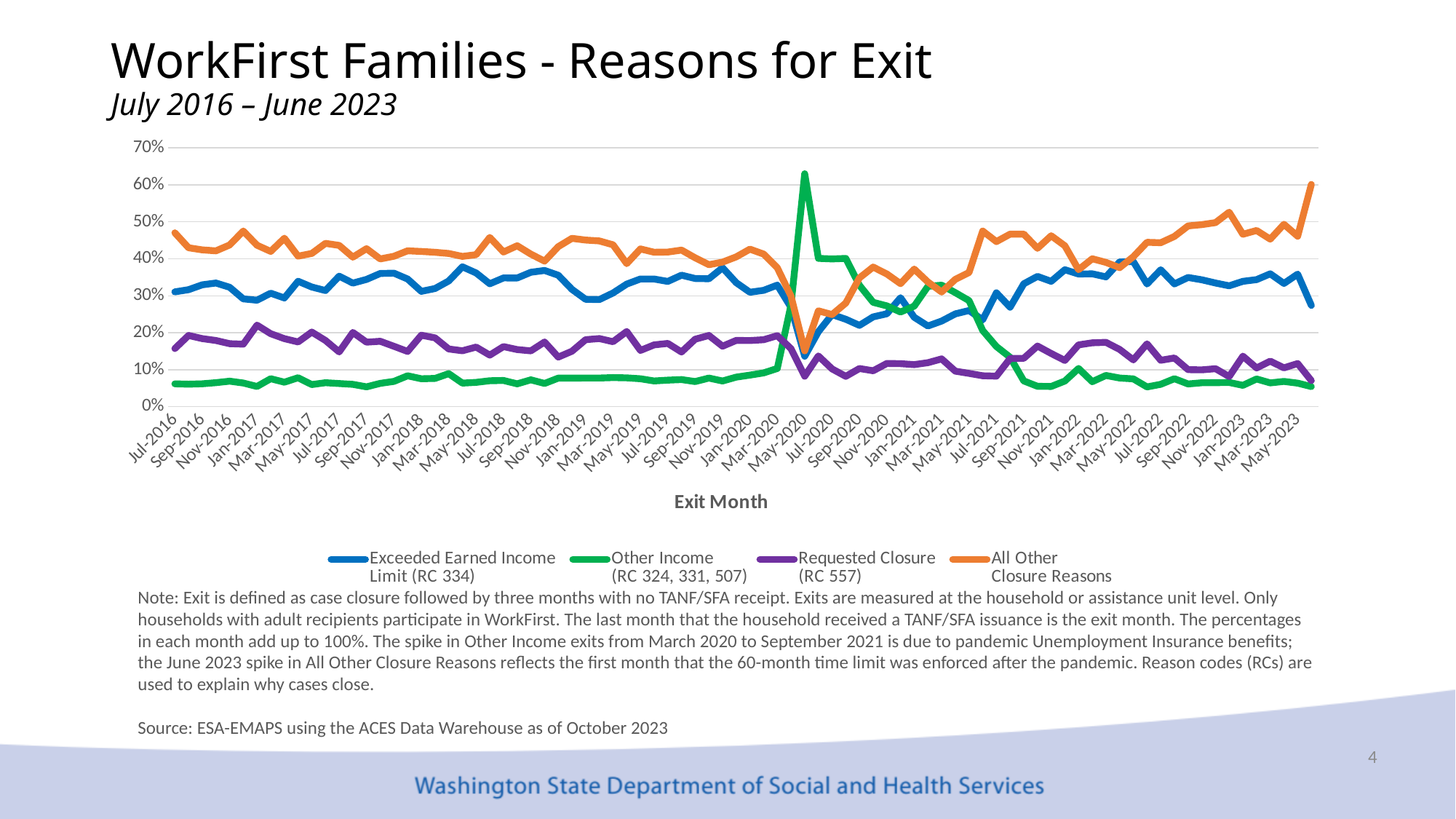
Does the Requested Closure series rise or fall overall from Jul-2016 to the end of the chart? fall What is the title of the x axis? Exit Month What are the four series named in the legend? Exceeded Earned Income Limit (RC 334), Other Income (RC 324, 331, 507), Requested Closure (RC 557), All Other Closure Reasons In Jul-2016, which series is higher: All Other Closure Reasons or Exceeded Earned Income Limit? All Other Closure Reasons Is the value for Other Income in May-2020 greater or less than 50%? greater Which series has the lowest value in Jul-2016? Other Income How many series does the legend list? 4 Is the value for All Other Closure Reasons at the final point of the chart greater or less than 50%? greater What kind of chart is shown on the slide? line chart Is the value for Other Income in Jul-2016 greater or less than 10%? less In May-2020, which series is higher: Other Income or All Other Closure Reasons? Other Income